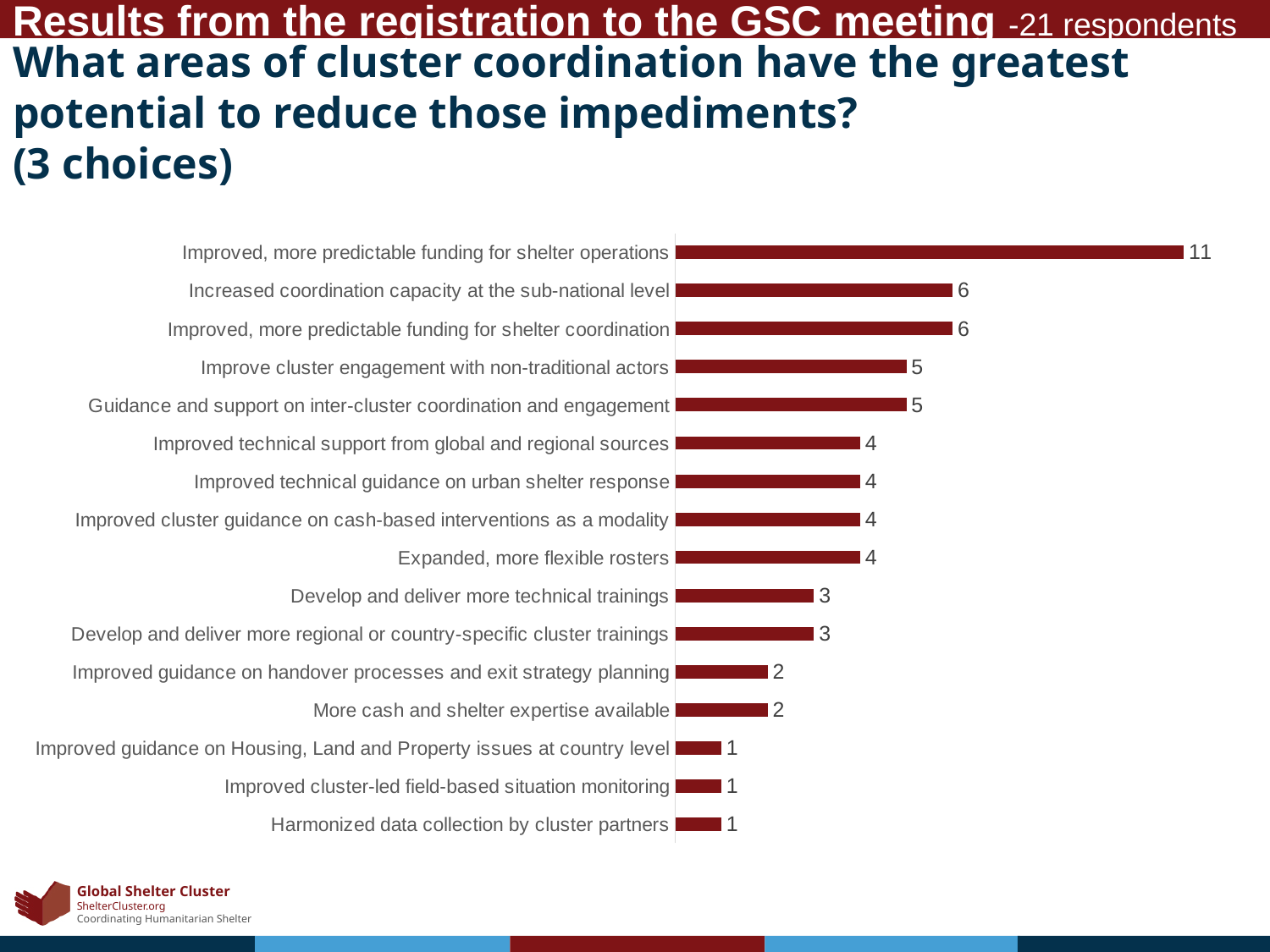
How many categories are shown in the chart? 16 What kind of chart is shown on the slide? Bar chart What is the difference between the values for "Improved, more predictable funding for shelter operations" and "Increased coordination capacity at the sub-national level"? 5 What value is shown for "Harmonized data collection by cluster partners"? 1 Which is larger: the value for "Improved technical support from global and regional sources" or the value for "Develop and deliver more regional or country-specific cluster trainings"? Improved technical support from global and regional sources Which category has the highest value? Improved, more predictable funding for shelter operations What value is shown for "Improved, more predictable funding for shelter operations"? 11 What is the difference between the values for "Develop and deliver more technical trainings" and "Improved guidance on handover processes and exit strategy planning"? 1 What colour are the bars in the chart? Dark red What value is shown for "Improve cluster engagement with non-traditional actors"? 5 What value is shown for "Expanded, more flexible rosters"? 4 What value is shown for "More cash and shelter expertise available"? 2